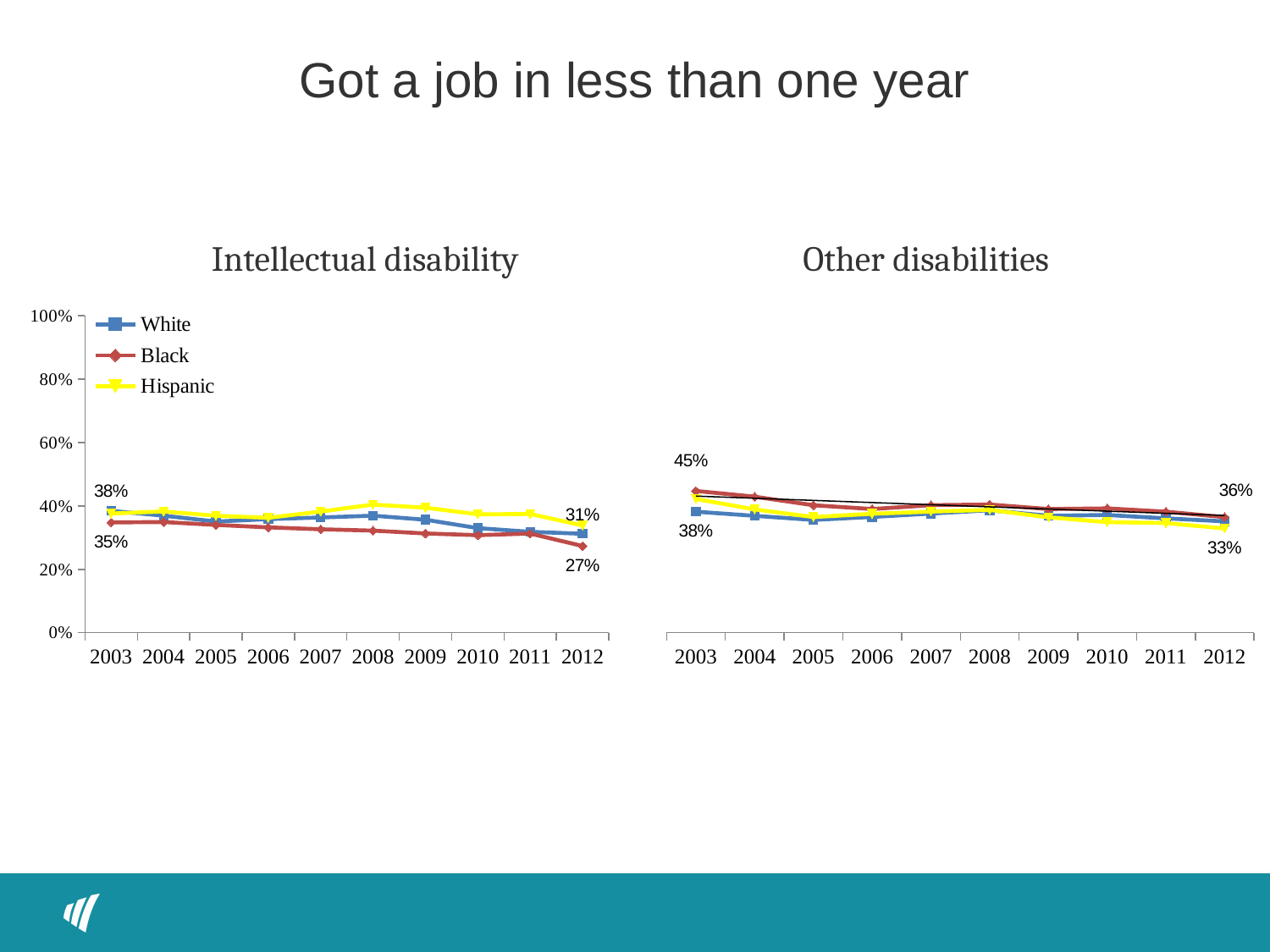
In the "Other disabilities" chart, which is larger in 2003, the value for Black or the value for White? Black How many years are shown on the x axis of the "Other disabilities" chart? 10 In the "Intellectual disability" chart, does the value for Black rise or fall from 2003 to 2012? fall How many series does the legend on the "Intellectual disability" chart list? 3 In the "Intellectual disability" chart, what is the value for Black in 2012? 27% In the "Intellectual disability" chart, what is the value for Black in 2003? 35% In the "Other disabilities" chart, what is the value for Black in 2003? 45% In the "Intellectual disability" chart, is the value for Hispanic in 2008 greater or less than 60%? less In the "Other disabilities" chart, what is the value for Hispanic in 2012? 33% In the "Intellectual disability" chart, by how many percentage points did the value for Black fall from 2003 to 2012? 8 percentage points In the "Other disabilities" chart, what is the difference between the Black value in 2003 and the White value in 2003? 7 percentage points What kind of chart is the "Intellectual disability" chart? line chart